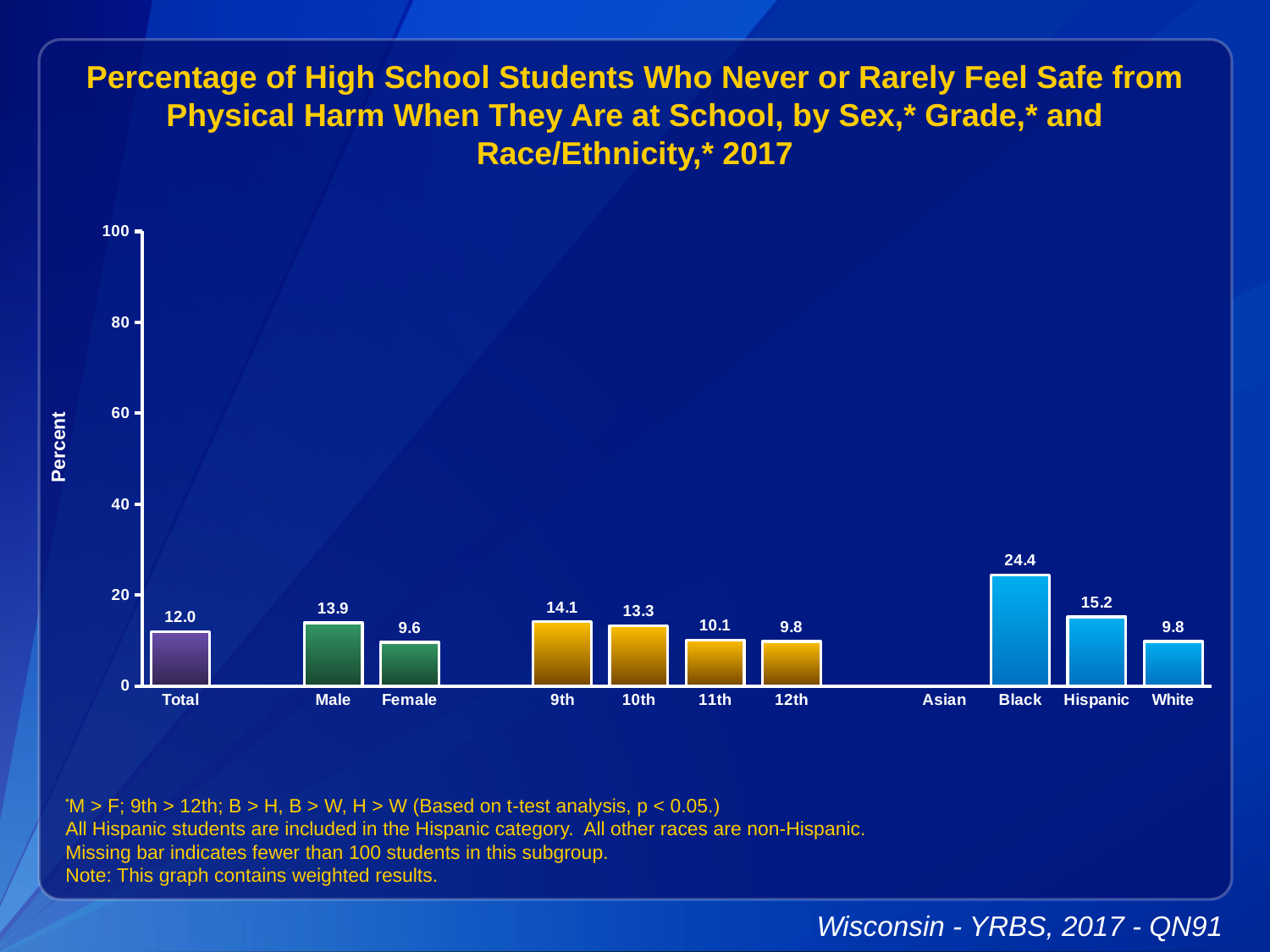
Which grade has the lowest value? 12th Which is larger, the value for 9th grade or 10th grade? 9th What is the value for Male? 13.9 Which category has the highest value? Black What is the difference between the Black and Hispanic values? 9.2 Is the value for Black greater or less than 20? greater What is the value for 11th grade? 10.1 What is the value for Black? 24.4 What is the difference between the Male and Female values? 4.3 What kind of chart is shown? bar chart What is the value for Total? 12.0 Which category has no bar shown? Asian